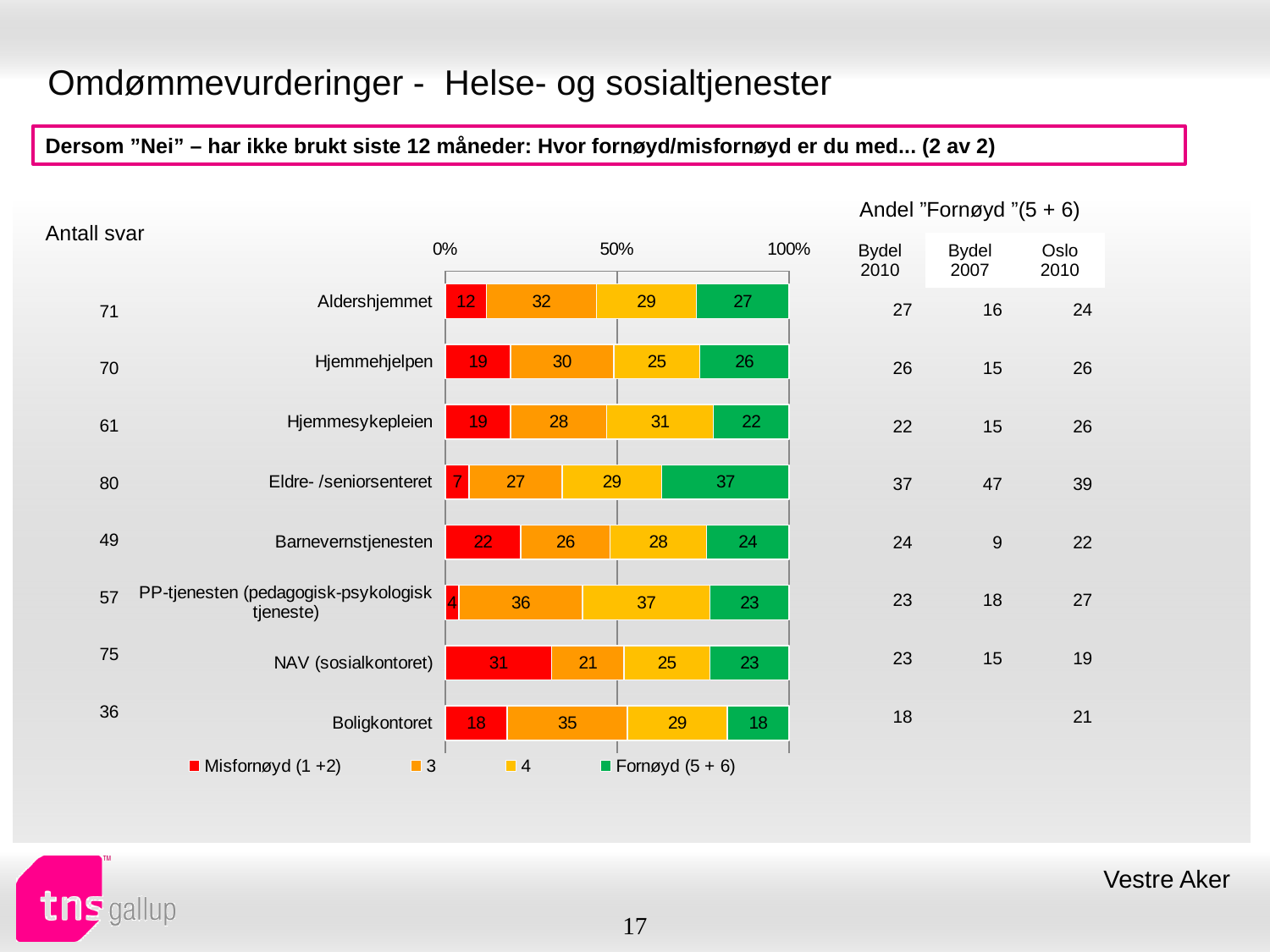
Which has the larger "Misfornøyd (1 +2)" value, Barnevernstjenesten or Boligkontoret? Barnevernstjenesten What kind of chart is shown on the slide? Stacked bar chart Which category has the lowest "Fornøyd (5 + 6)" value? Boligkontoret Which category has the highest "Fornøyd (5 + 6)" value? Eldre- /seniorsenteret What is the difference between the "Fornøyd (5 + 6)" values for Eldre- /seniorsenteret and Boligkontoret? 19 How many categories are shown in the chart? 8 Which category has the highest "Misfornøyd (1 +2)" value? NAV (sosialkontoret) What is the value of the "Misfornøyd (1 +2)" segment for NAV (sosialkontoret)? 31 Which category has the lowest "Misfornøyd (1 +2)" value? PP-tjenesten (pedagogisk-psykologisk tjeneste) How many series does the legend list? 4 What is the value of the "4" segment for PP-tjenesten (pedagogisk-psykologisk tjeneste)? 37 What is the value of the "Fornøyd (5 + 6)" segment for Eldre- /seniorsenteret? 37